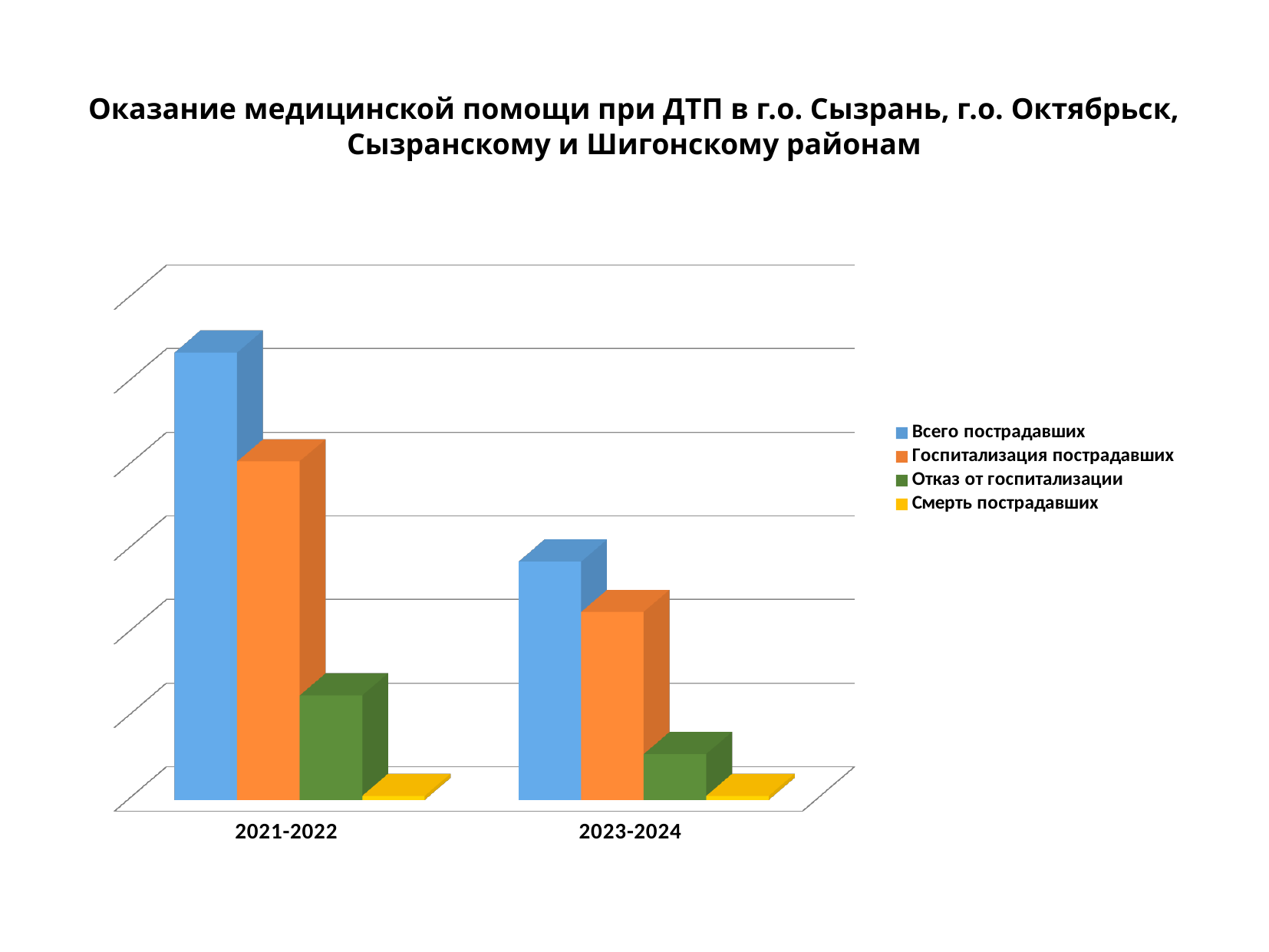
How many series does the legend list? 4 What are the two period labels on the x axis? 2021-2022 and 2023-2024 Do the values for Госпитализация пострадавших rise or fall from 2021-2022 to 2023-2024? fall Which series has the lowest value in 2023-2024? Смерть пострадавших How many categories (periods) are shown on the x axis? 2 Which series has the highest value in 2021-2022? Всего пострадавших Which series has the lowest value in 2021-2022? Смерть пострадавших What kind of chart is shown on the slide? bar chart Which series is shown in yellow in the legend? Смерть пострадавших Is the value for Отказ от госпитализации larger in 2021-2022 or in 2023-2024? 2021-2022 Is the value for Всего пострадавших larger in 2021-2022 or in 2023-2024? 2021-2022 In 2023-2024, which is larger: Госпитализация пострадавших or Отказ от госпитализации? Госпитализация пострадавших